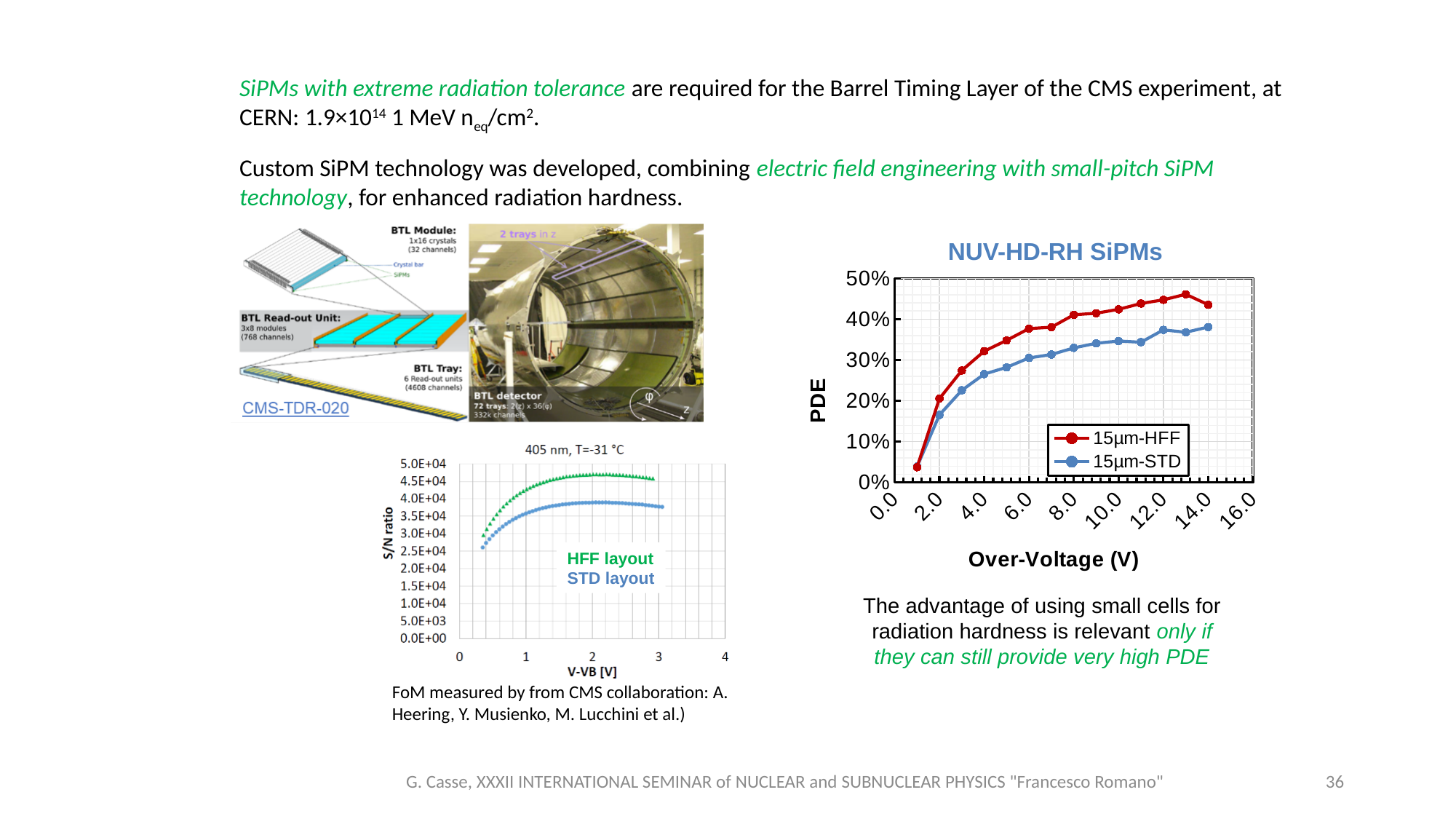
On the S/N ratio chart titled 405 nm, T=-31 °C, how many series are plotted? 2 On the S/N ratio chart titled 405 nm, T=-31 °C, is the S/N ratio of the HFF layout at V-VB = 2 V greater or less than 4.0E+04? greater On the NUV-HD-RH SiPMs chart, what are the two legend entries? 15µm-HFF and 15µm-STD On the NUV-HD-RH SiPMs chart, is the highest PDE reached by 15µm-HFF greater or less than 40%? greater On the NUV-HD-RH SiPMs chart, how many series does the legend list? 2 On the S/N ratio chart titled 405 nm, T=-31 °C, which layout has the higher S/N ratio at V-VB = 2 V? HFF layout On the NUV-HD-RH SiPMs chart, which series has the higher PDE at an over-voltage of 8.0 V? 15µm-HFF On the NUV-HD-RH SiPMs chart, is the PDE of 15µm-HFF at 8.0 V over-voltage greater or less than 30%? greater On the NUV-HD-RH SiPMs chart, what is the label of the x axis? Over-Voltage (V) On the NUV-HD-RH SiPMs chart, does the PDE of 15µm-STD generally rise or fall as over-voltage increases? rises On the NUV-HD-RH SiPMs chart, what kind of chart is shown? line chart